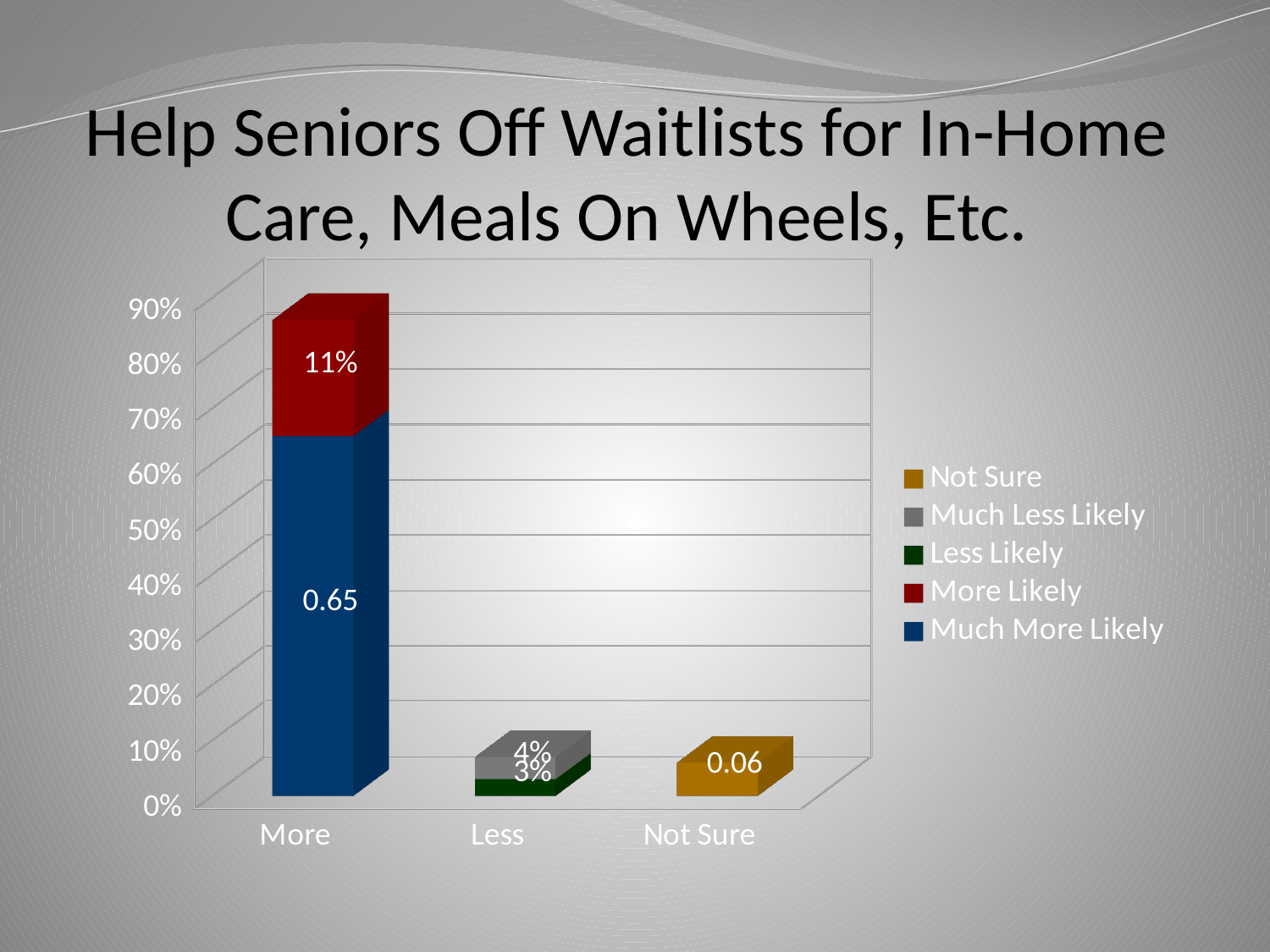
Which legend entry is shown in dark red? More Likely Which category has the tallest bar? More What is the data label for the Much Less Likely segment of the Less bar? 4% Is the total height of the More bar greater or less than 70%? greater What is the data label for the Less Likely segment of the Less bar? 3% What is the data label for the More Likely segment of the More bar? 11% What is the total of the Less stacked bar? 7% How many categories are shown on the x axis? 3 What kind of chart is shown on the slide? bar chart What is the data label for the Much More Likely segment of the More bar? 0.65 How many series does the legend list? 5 What is the data label on the Not Sure bar? 0.06